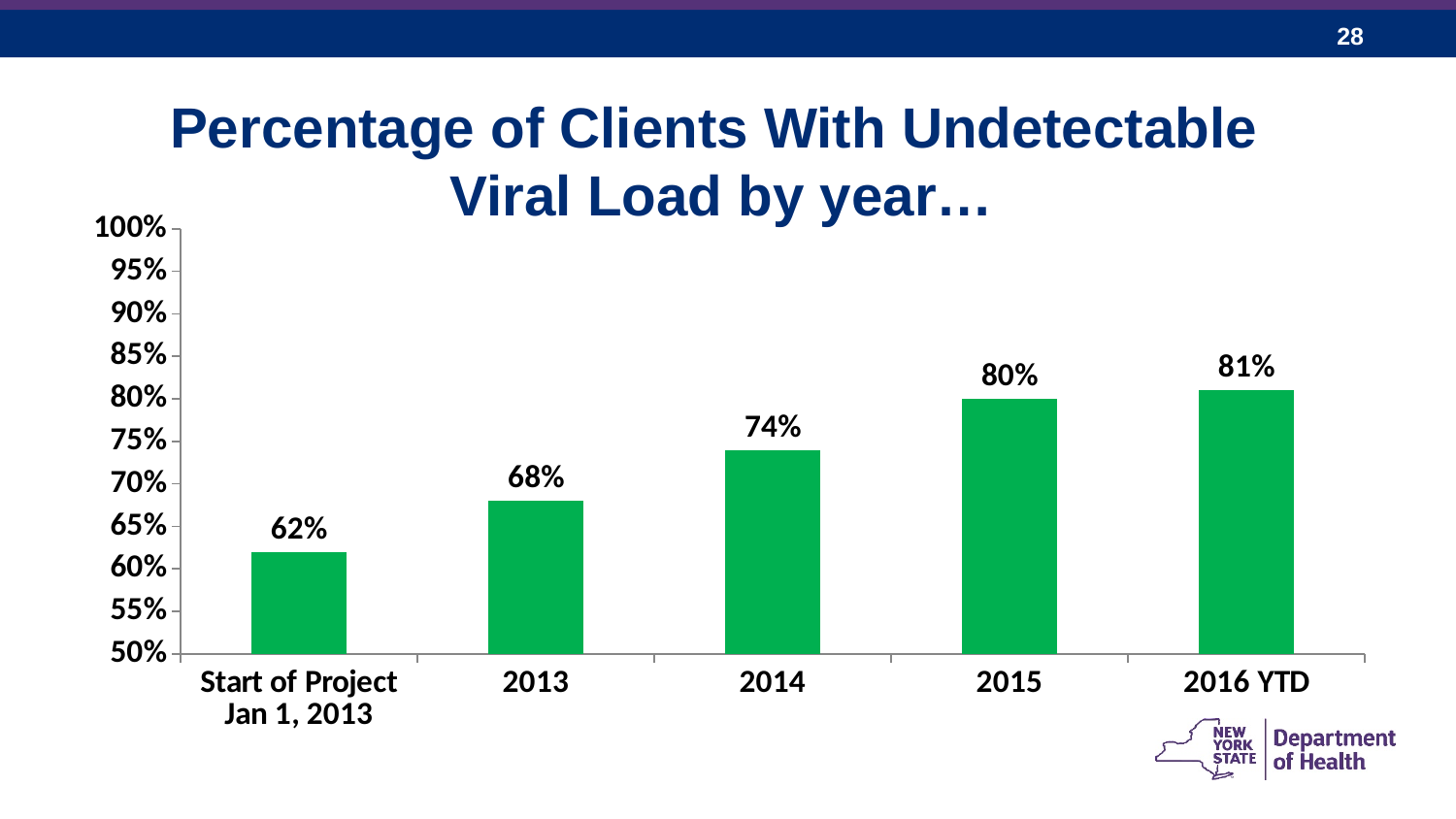
How many categories are shown on the x axis? 5 Which category has the highest percentage of clients with undetectable viral load? 2016 YTD Is the value for 2015 greater or less than 75%? greater What is the difference between the 2016 YTD value and the Start of Project value? 19% What is the difference between the 2015 value and the 2013 value? 12% What kind of chart is shown on the slide? Bar chart What is the percentage of clients with undetectable viral load in 2014? 74% Do the values rise or fall from Start of Project to 2016 YTD? Rise What is the value shown for Start of Project Jan 1, 2013? 62% Which category has the lowest percentage of clients with undetectable viral load? Start of Project Jan 1, 2013 What is the value shown for 2016 YTD? 81% Which is larger, the value for 2014 or the value for 2013? 2014